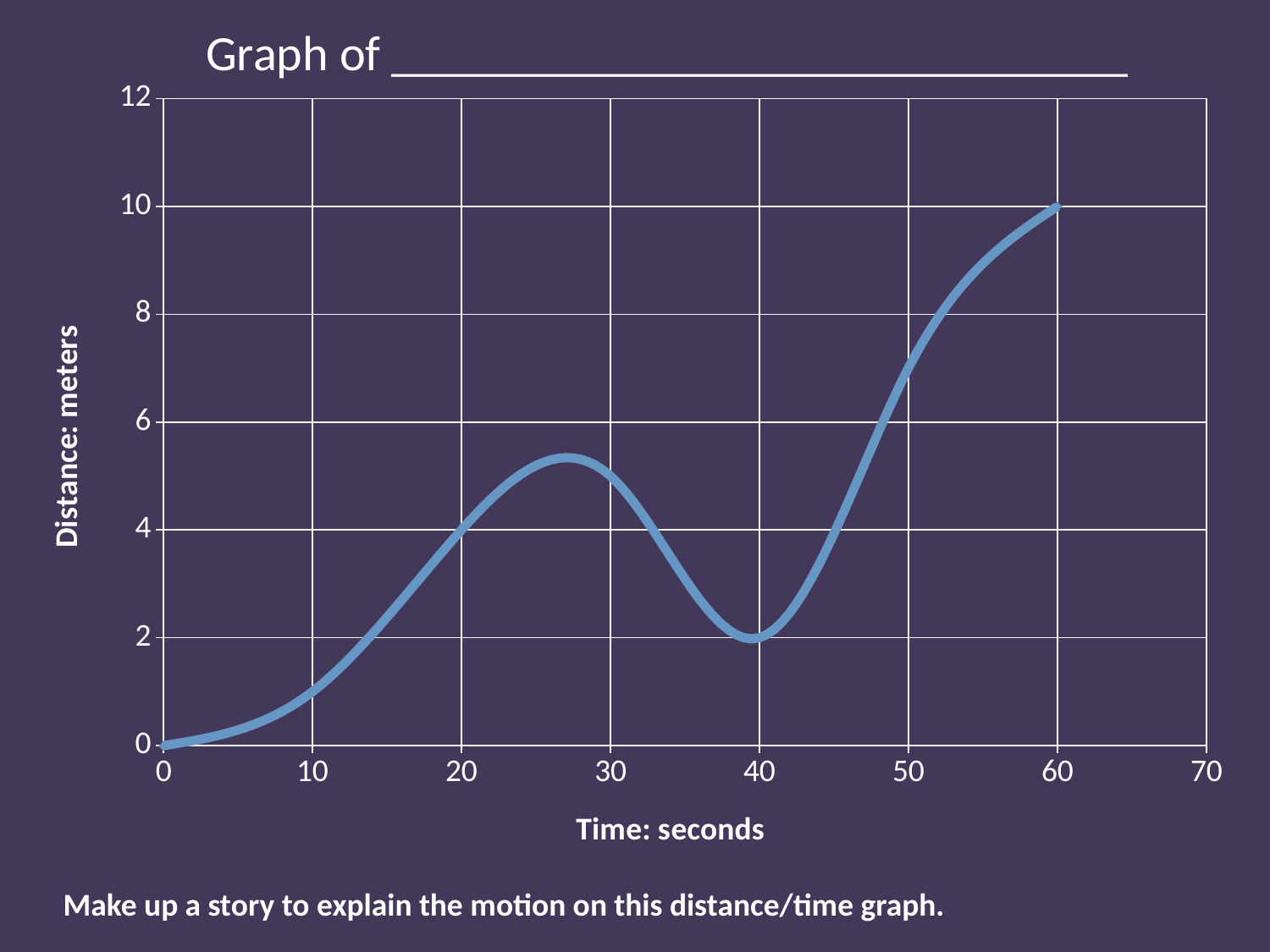
What is the distance at 20 seconds? 4 Is the distance at 50 seconds greater or less than 6? greater Is the distance at 10 seconds greater or less than 2? less What is the distance at 40 seconds? 2 What kind of chart is shown on the slide? line chart Which is larger, the distance at 20 seconds or at 40 seconds? 20 seconds Is the distance at 30 seconds greater or less than 4? greater What is the distance at 60 seconds? 10 What is the distance at 0 seconds? 0 At what time is the distance highest? 60 seconds What is the label of the vertical axis? Distance: meters What is the difference between the distance at 60 seconds and at 40 seconds? 8